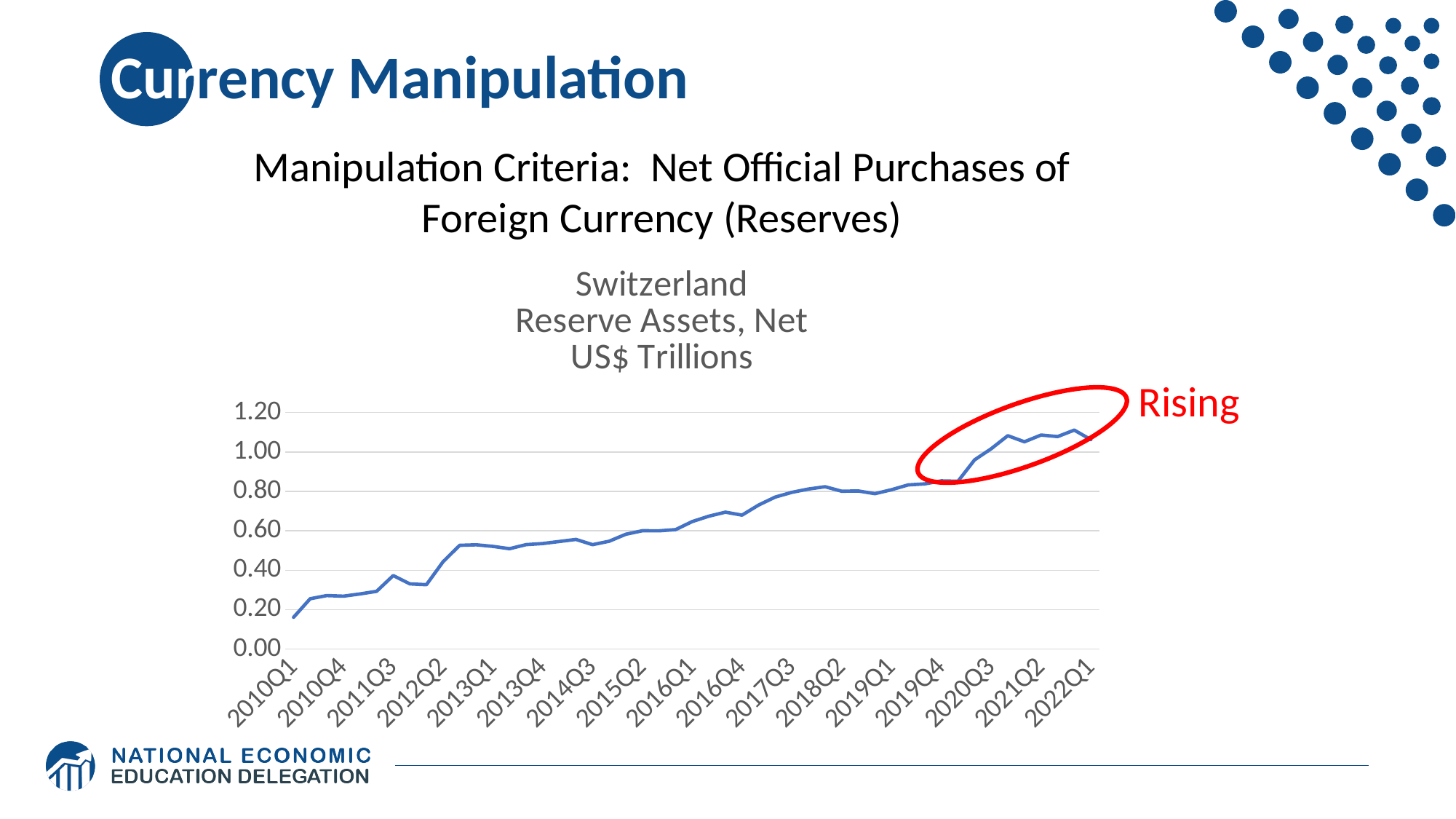
Is the value for 2021Q2 greater or less than 1.00? greater Is the value for 2022Q1 greater or less than 1.00? greater Is the value for 2013Q1 greater or less than 0.60? less Which quarter has the lowest value on the chart? 2010Q1 What is the title of the chart? Switzerland Reserve Assets, Net US$ Trillions What kind of chart is shown on the slide? line chart Which is larger, the value for 2016Q4 or the value for 2012Q2? 2016Q4 What word is written in red next to the circled part of the line? Rising Do the values generally rise or fall from 2010Q1 to 2022Q1? rise